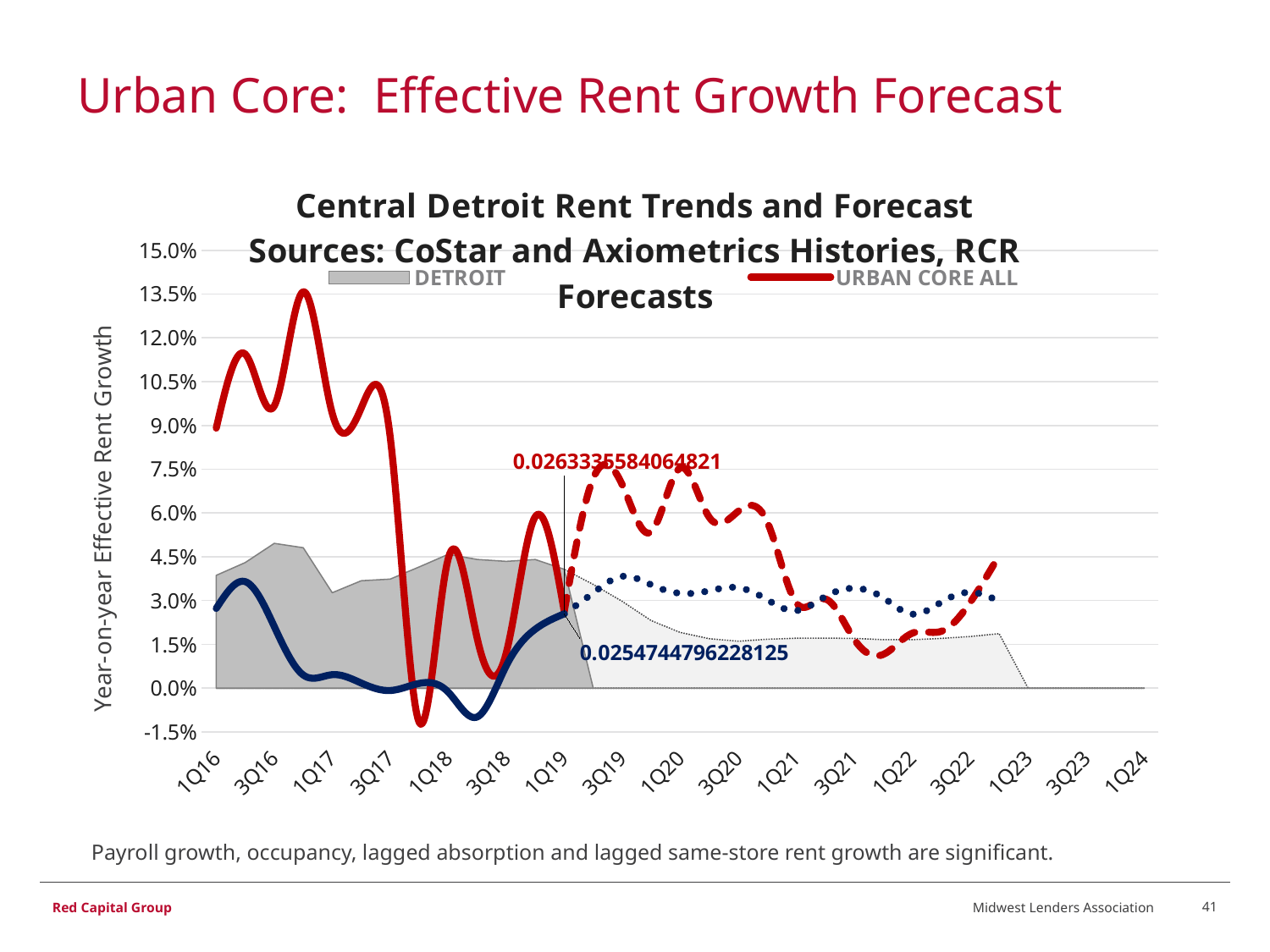
Does the URBAN CORE ALL line rise or fall overall from 1Q16 to 1Q18? fall How many series does the chart legend list? 2 What is the blue data label value shown on the chart at 1Q19? 0.0254744796228125 Is the DETROIT value at 3Q16 greater or less than 3.0%? greater What is the red data label value shown on the URBAN CORE ALL line at 1Q19? 0.0263335584064821 Is the URBAN CORE ALL value at 1Q16 greater or less than 7.5%? greater Is the URBAN CORE ALL value at 3Q19 greater or less than 6.0%? greater Which of the two data labels printed at 1Q19 is larger, the red one or the blue one? the red one (0.0263335584064821) What is the difference between the red data label (0.0263335584064821) and the blue data label (0.0254744796228125)? 0.0008590787836696 What are the two series named in the chart legend? DETROIT and URBAN CORE ALL What type of chart is shown on the slide? combination area and line chart How many quarter labels are shown on the x axis? 17